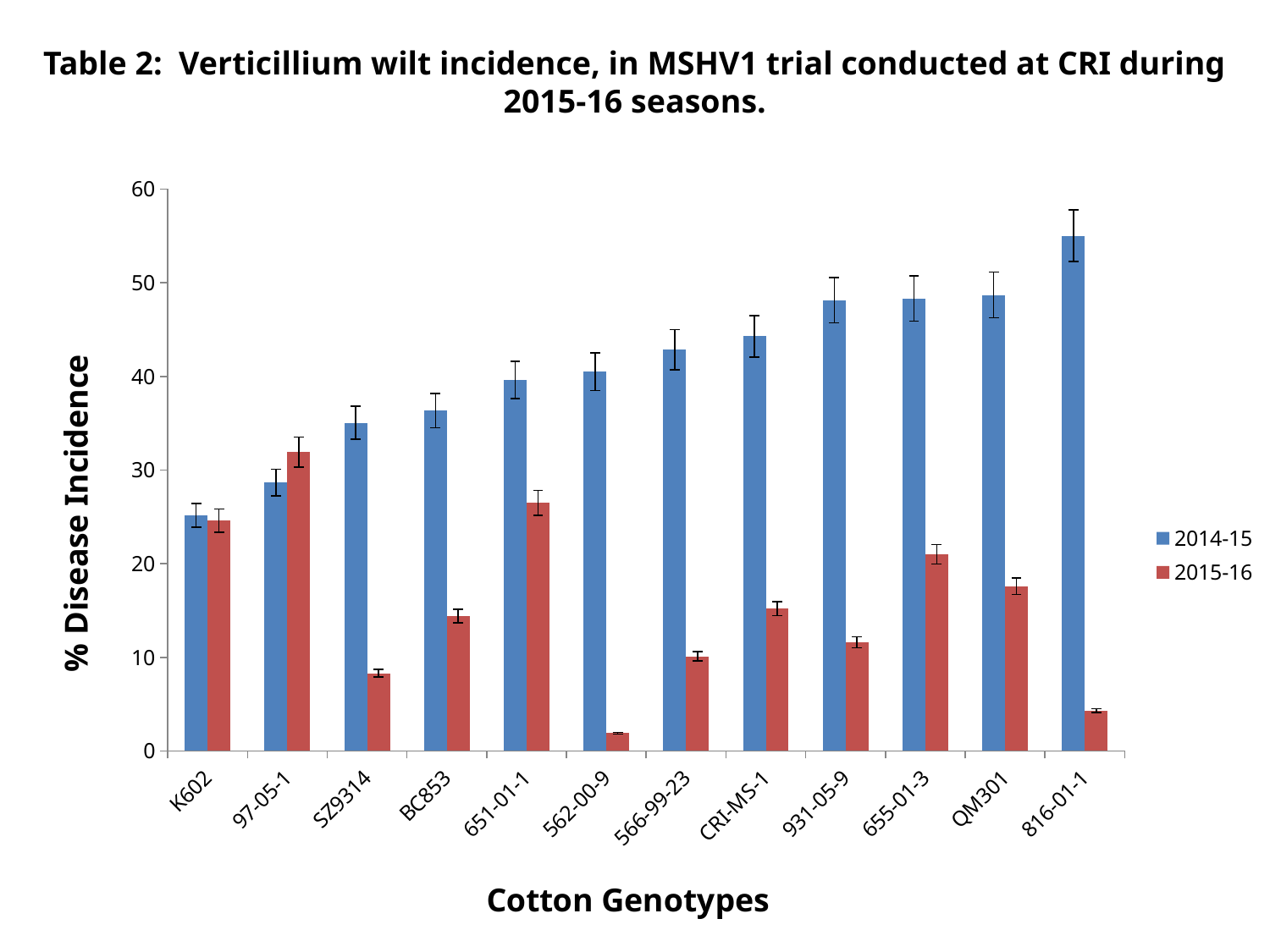
Which genotype has the lowest 2015-16 disease incidence? 562-00-9 What kind of chart is shown on the slide? bar chart Which genotype has the highest 2015-16 disease incidence? 97-05-1 How many series does the legend list? 2 Is the 2015-16 value for SZ9314 greater or less than 10? less What is the label of the y axis? % Disease Incidence For 97-05-1, which series has the larger value, 2014-15 or 2015-16? 2015-16 How many cotton genotypes are shown on the x axis? 12 Is the 2014-15 value for 816-01-1 greater or less than 50? greater Which genotype has the lowest 2014-15 disease incidence? K602 Do the 2014-15 values generally rise or fall moving left to right along the x axis? rise Which genotype has the highest 2014-15 disease incidence? 816-01-1